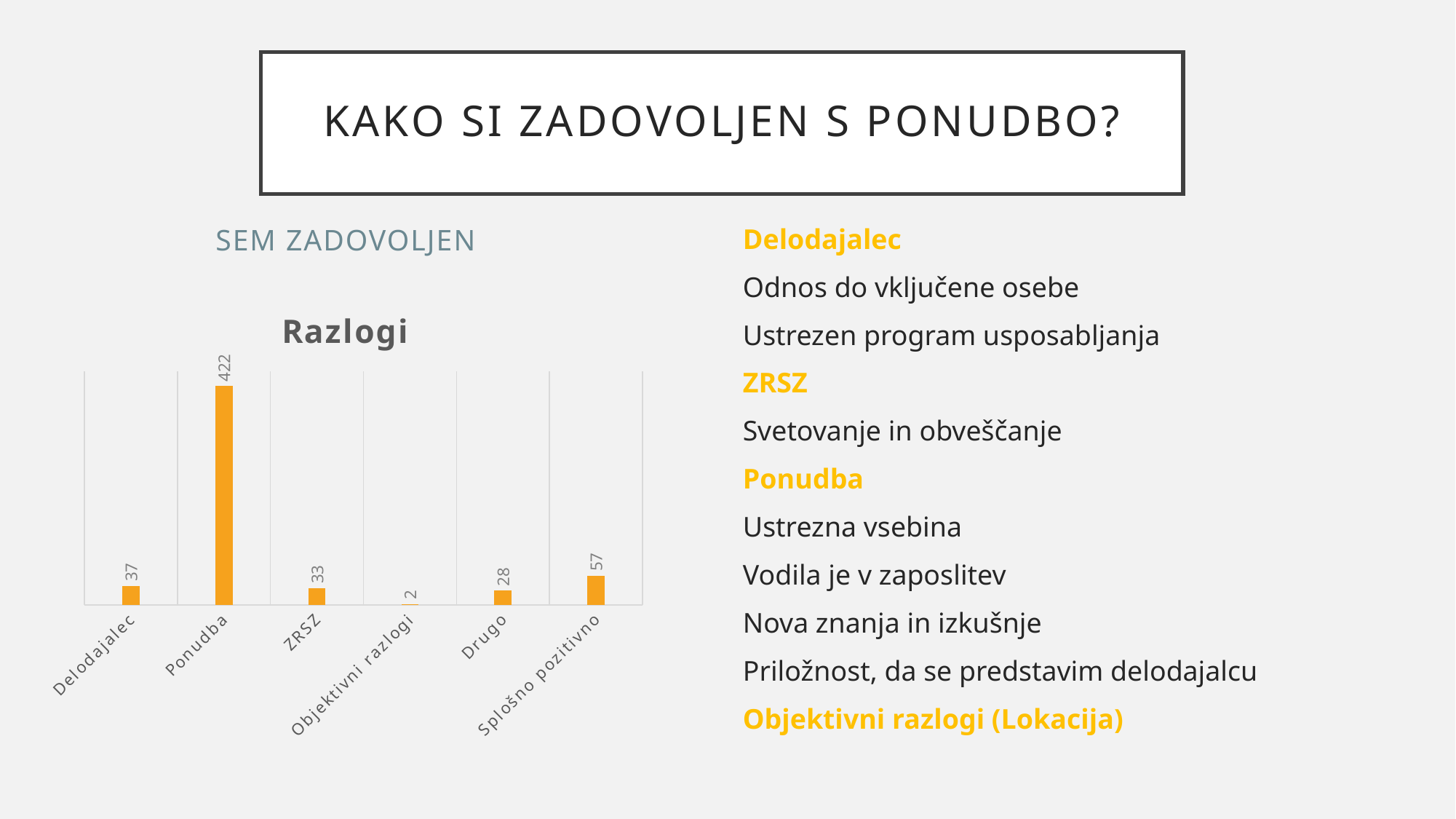
How many categories are shown in the Razlogi chart? 6 What is the value for Objektivni razlogi in the Razlogi chart? 2 What is the title of the chart on the slide? Razlogi What is the difference between the values for Delodajalec and ZRSZ in the Razlogi chart? 4 Which category has the highest value in the Razlogi chart? Ponudba Which category has the lowest value in the Razlogi chart? Objektivni razlogi What is the value for Ponudba in the Razlogi chart? 422 Which is larger in the Razlogi chart, the value for Drugo or the value for Splošno pozitivno? Splošno pozitivno What kind of chart is the Razlogi chart? bar chart What is the value for Delodajalec in the Razlogi chart? 37 What is the value for Splošno pozitivno in the Razlogi chart? 57 What is the difference between the values for Ponudba and Splošno pozitivno in the Razlogi chart? 365